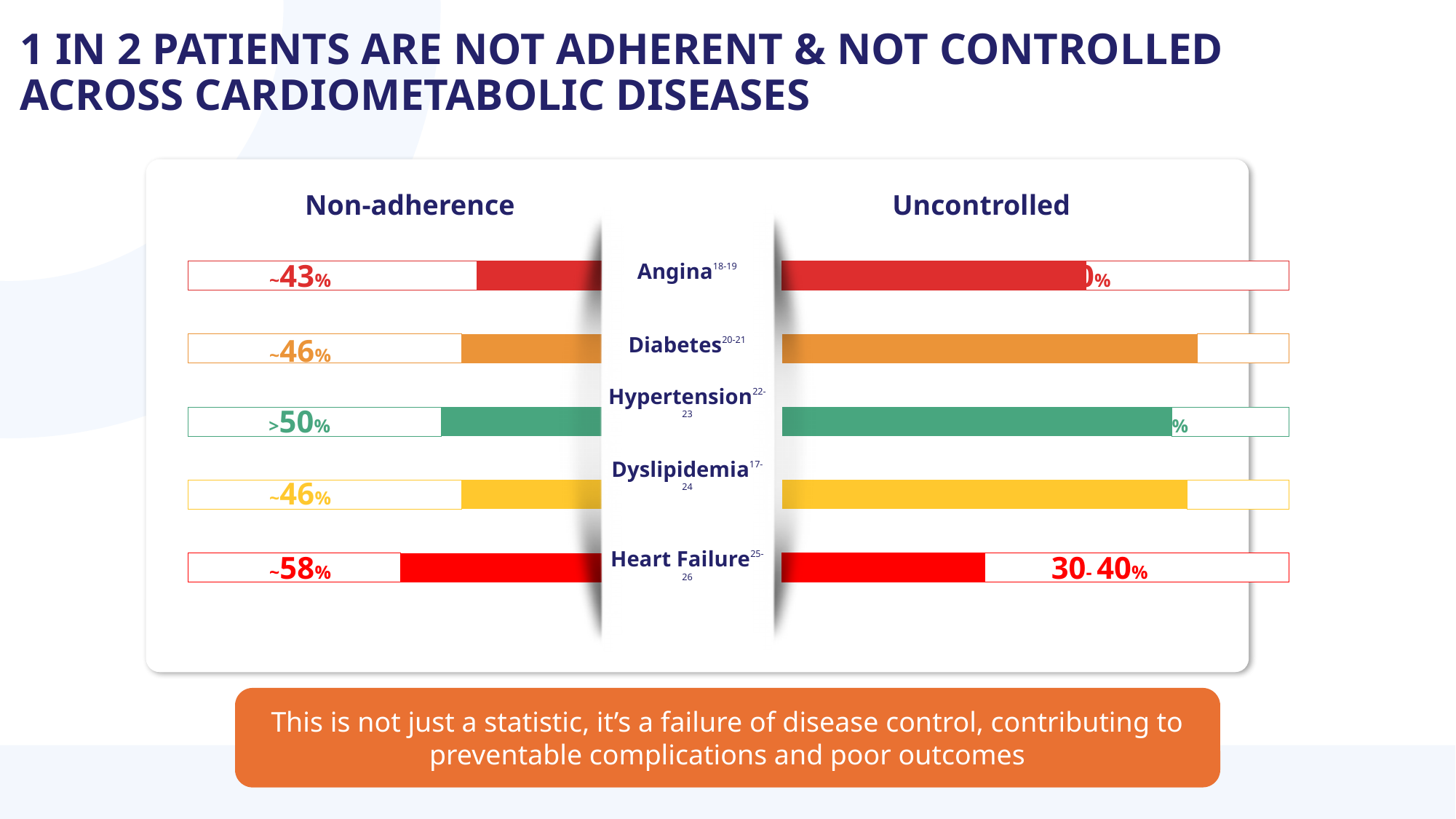
What is the non-adherence value shown for Diabetes? ~46% How many diseases are listed in the chart? 5 What is the non-adherence value shown for Heart Failure? ~58% What is the uncontrolled value shown for Heart Failure? 30-40% Which disease has the lowest non-adherence value? Angina What is the non-adherence value shown for Hypertension? >50% What is the non-adherence value shown for Angina? ~43% Which disease has the shortest bar on the Uncontrolled side? Heart Failure What colour are the bars for Hypertension? green What kind of chart is shown on the slide? bar chart On the Uncontrolled side, is the bar for Diabetes longer or shorter than the bar for Heart Failure? longer Which disease has the highest non-adherence value? Heart Failure